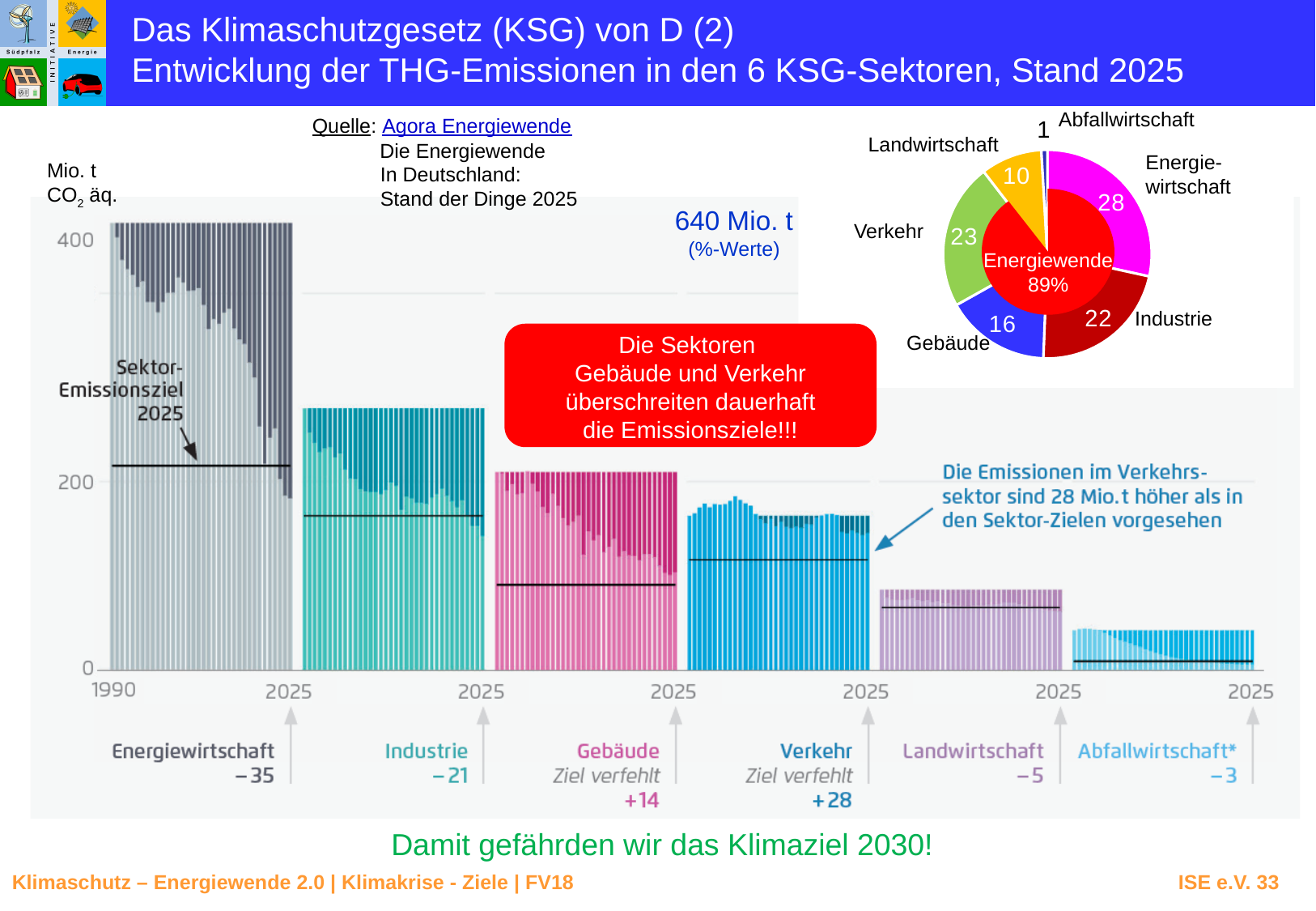
In the large emissions chart, what deviation from the 2025 sector target is printed for Energiewirtschaft? −35 In the pie chart at the top right, what percentage share is shown for Verkehr? 23 In the large emissions chart, is the 2025 sector target line for Industrie greater or less than 200? less In the pie chart at the top right, what is the difference between the shares of Energiewirtschaft and Gebäude? 12 In the pie chart at the top right, what total amount of emissions do the percentages refer to? 640 Mio. t In the pie chart at the top right, what percentage share is shown for Energiewirtschaft? 28 In the pie chart at the top right, how many sectors are shown? 6 In the large emissions chart, what deviation from the 2025 sector target is printed for Verkehr? +28 In the pie chart at the top right, which sector has the smallest share? Abfallwirtschaft In the large emissions chart, which two sectors are labelled 'Ziel verfehlt'? Gebäude and Verkehr In the large emissions chart, do the emissions of Energiewirtschaft rise or fall from 1990 to 2025? fall In the pie chart at the top right, which sector has the largest share? Energiewirtschaft